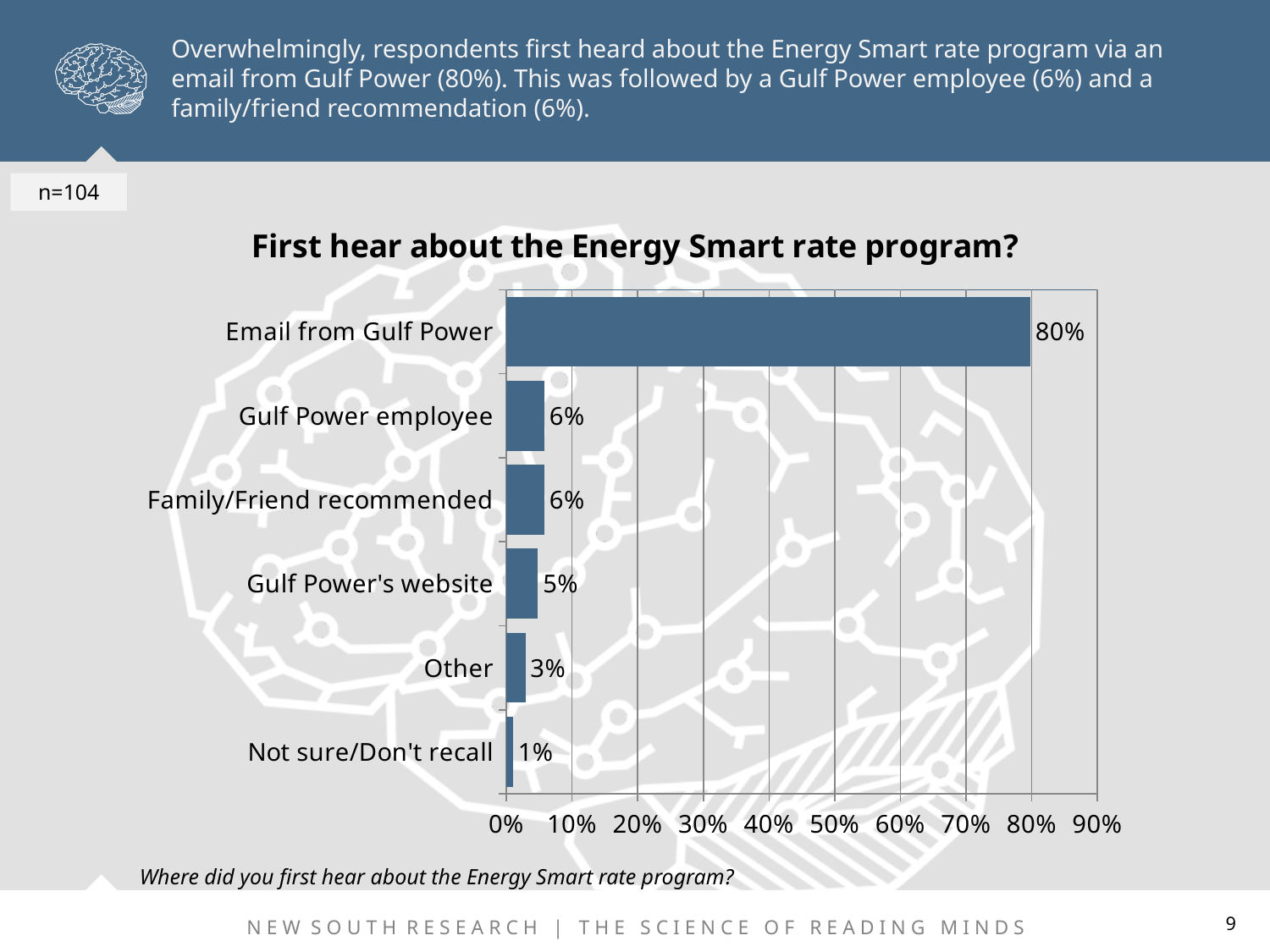
Which is larger, the value for Gulf Power's website or the value for Other? Gulf Power's website What is the value for Gulf Power's website? 5% What percentage of respondents first heard about the Energy Smart rate program via an email from Gulf Power? 80% Is the value for Email from Gulf Power greater or less than 70%? greater What is the value for Other? 3% Which category has the lowest value? Not sure/Don't recall What is the value for Not sure/Don't recall? 1% What is the difference between the values for Email from Gulf Power and Gulf Power employee? 74% What is the title of the chart? First hear about the Energy Smart rate program? Which category has the highest value? Email from Gulf Power What kind of chart is shown on the slide? Bar chart How many categories are shown in the chart? 6